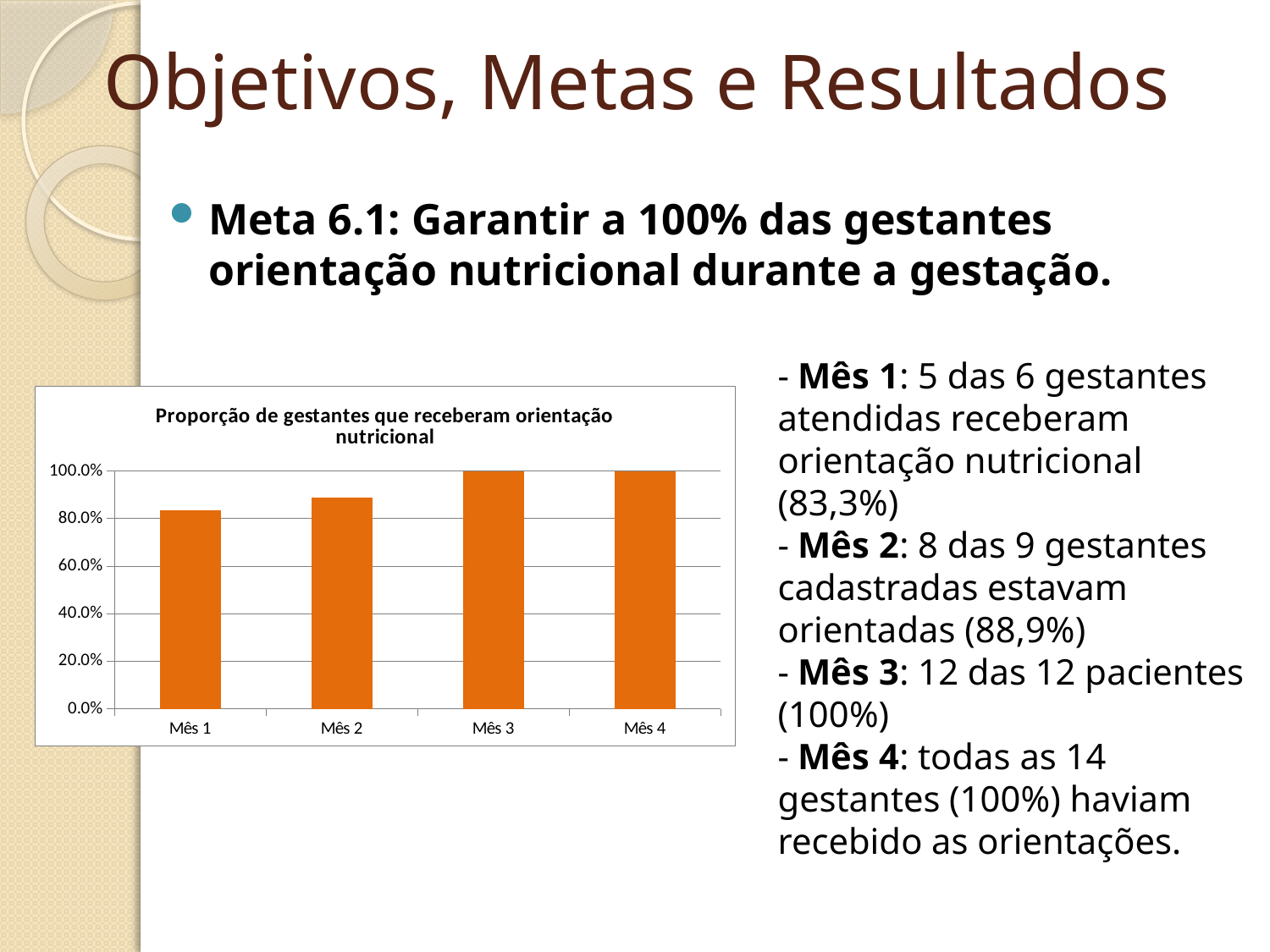
What is the value for Mês 4 in the chart? 100.0% What colour are the bars in the chart? orange What is the title of the chart? Proporção de gestantes que receberam orientação nutricional Is the value for Mês 2 greater or less than 80.0%? greater Which month has the lowest value in the chart? Mês 1 Which is larger, the value for Mês 1 or the value for Mês 2? Mês 2 Is the value for Mês 2 greater or less than 100.0%? less How many categories (months) are shown on the x axis of the chart? 4 Do the values rise or fall from Mês 1 to Mês 4? rise What kind of chart is shown on the slide? bar chart What is the value for Mês 3 in the chart? 100.0% Is the value for Mês 1 greater or less than 100.0%? less